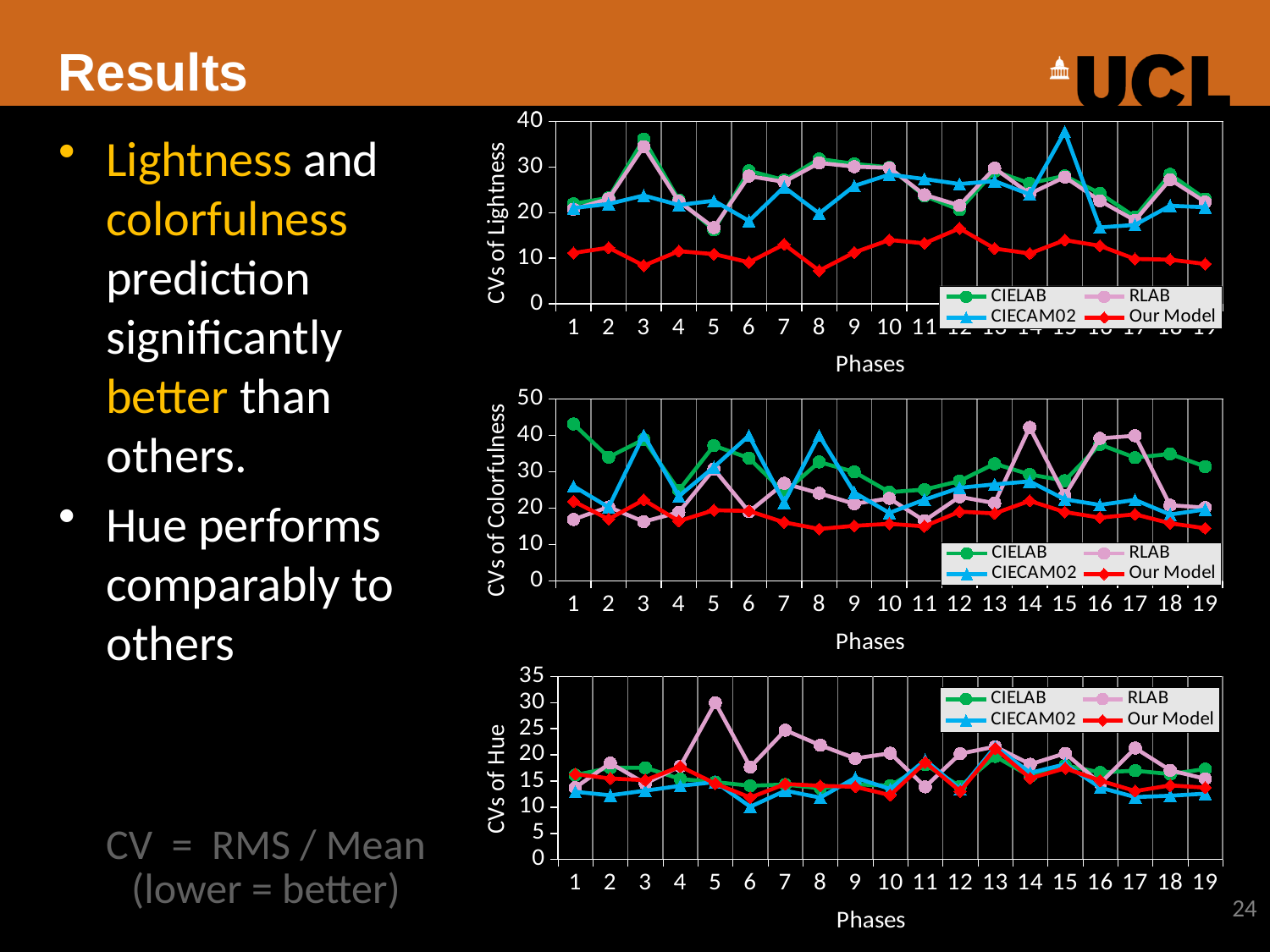
How many phases are plotted along the x axis of the CVs of Hue chart? 19 In the CVs of Hue chart, is the RLAB value at phase 5 greater or less than 25? greater In the CVs of Colorfulness chart, is the Our Model value at phase 8 greater or less than 20? less What kind of chart is the top chart (CVs of Lightness)? line chart In the CVs of Lightness chart, is the CIECAM02 value at phase 15 greater or less than 30? greater In the CVs of Hue chart, which series has the highest value at phase 5? RLAB In the CVs of Lightness chart, which series has the lowest values across the phases? Our Model In the CVs of Colorfulness chart, at phase 1, which is larger: CIELAB or CIECAM02? CIELAB How many series does the legend of the CVs of Colorfulness chart list? 4 What is the x-axis title of the CVs of Hue chart? Phases